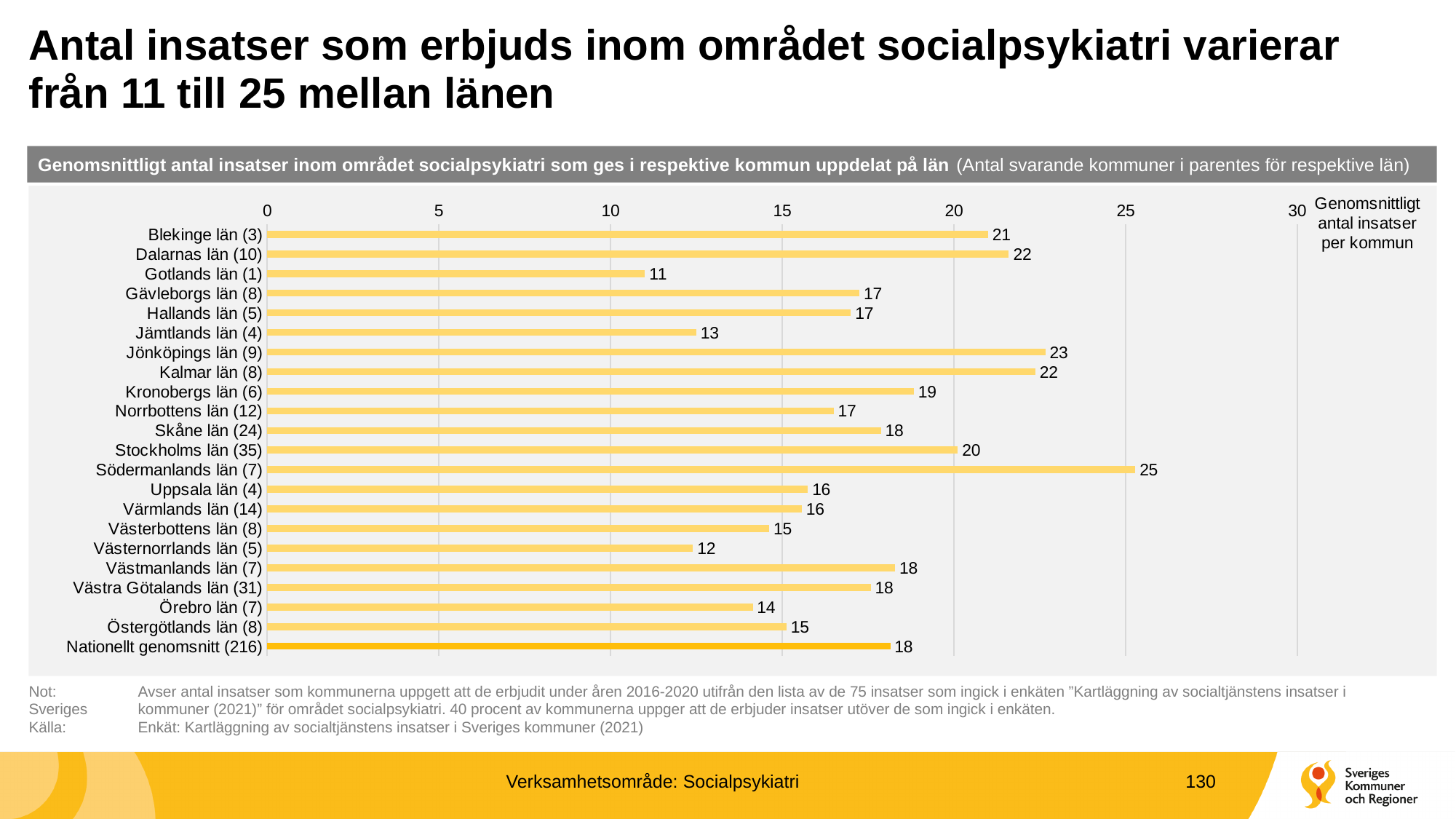
What is the value for Stockholms län (35)? 20 Which category has the highest value? Södermanlands län (7) Which category has the lowest value? Gotlands län (1) What is the label shown at the top right of the chart describing the axis? Genomsnittligt antal insatser per kommun How many categories (bars) are shown in the chart? 22 What kind of chart is shown on the slide? Bar chart What is the difference between the values for Jönköpings län (9) and Jämtlands län (4)? 10 Is the value for Västernorrlands län (5) greater or less than 15? less What is the value for Gotlands län (1)? 11 What is the value for Nationellt genomsnitt (216)? 18 Which is larger, the value for Kalmar län (8) or the value for Kronobergs län (6)? Kalmar län (8) What is the value for Södermanlands län (7)? 25